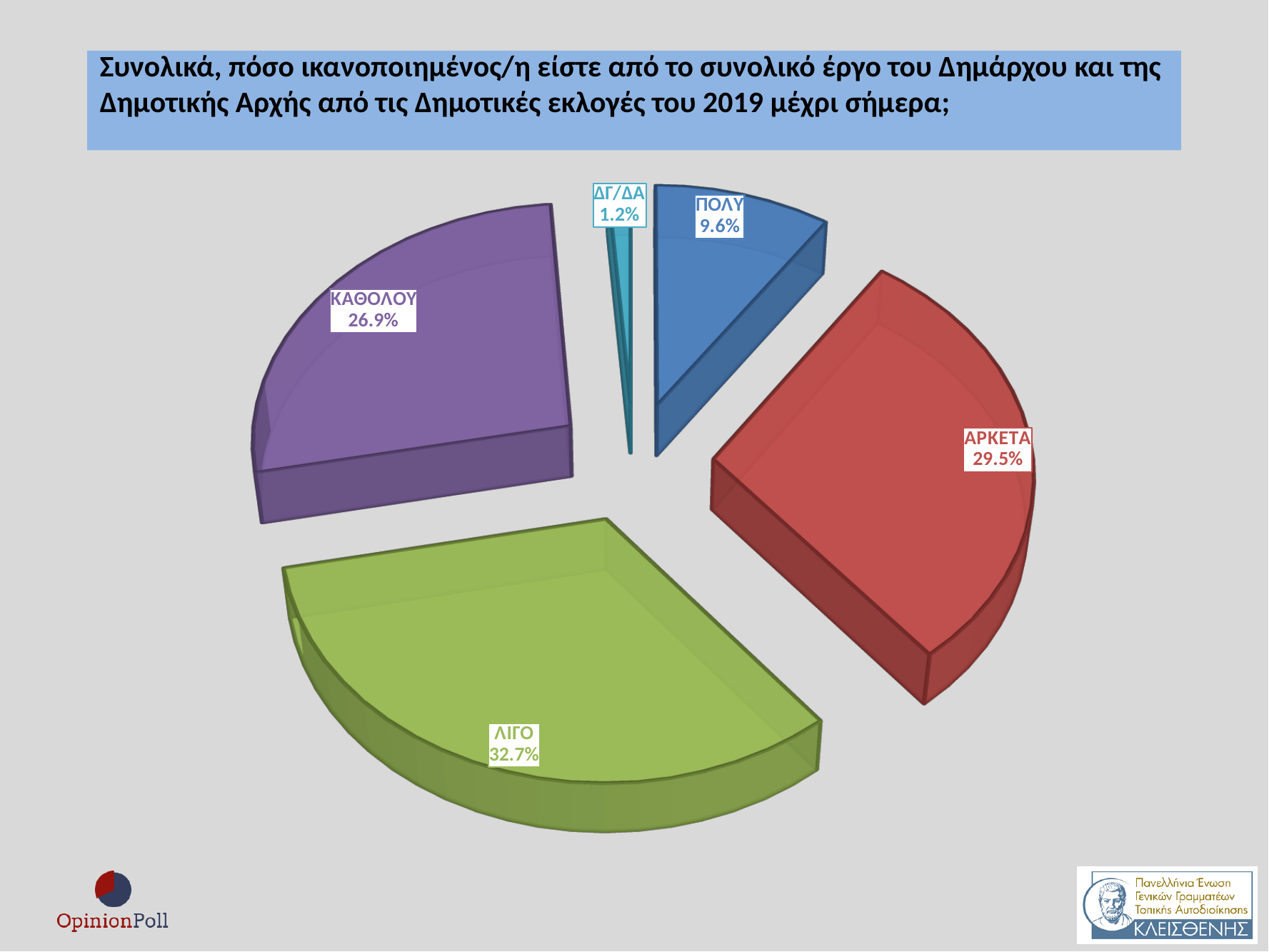
What is the difference in percentage points between ΑΡΚΕΤΑ and ΠΟΛΥ? 19.9 Which is larger, the share for ΚΑΘΟΛΟΥ or the share for ΠΟΛΥ? ΚΑΘΟΛΟΥ What percentage of respondents answered ΔΓ/ΔΑ? 1.2% Which response has the smallest share of the pie? ΔΓ/ΔΑ What percentage of respondents answered ΛΙΓΟ? 32.7% What is the difference in percentage points between ΛΙΓΟ and ΑΡΚΕΤΑ? 3.2 How many slices does the pie chart have? 5 Which response has the largest share of the pie? ΛΙΓΟ What kind of chart is shown on the slide? Pie chart What percentage of respondents answered ΠΟΛΥ? 9.6% What percentage of respondents answered ΚΑΘΟΛΟΥ? 26.9% What percentage of respondents answered ΑΡΚΕΤΑ? 29.5%